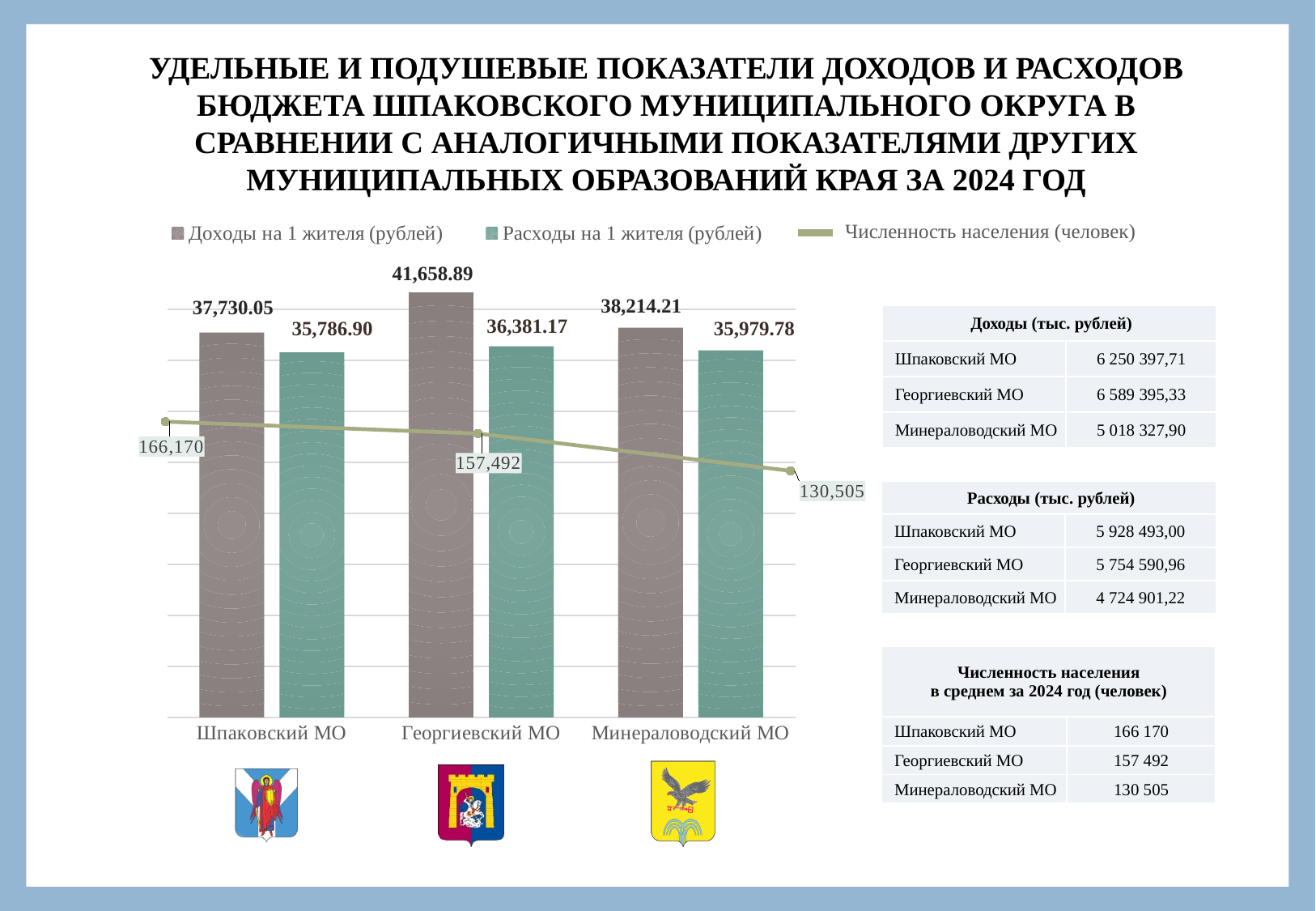
Does the Численность населения line rise or fall from Шпаковский МО to Минераловодский МО? Falls How many municipalities are shown on the x axis of the chart? 3 What is the difference in Численность населения between Шпаковский МО and Минераловодский МО? 35,665 What is the difference between Доходы на 1 жителя and Расходы на 1 жителя for Георгиевский МО? 5,277.72 How many series does the chart legend list? 3 What kind of chart is shown on the slide? Combined bar and line chart Which municipality has the highest Доходы на 1 жителя (рублей)? Георгиевский МО What is the Численность населения (человек) value shown for Минераловодский МО? 130,505 What is the value of Доходы на 1 жителя (рублей) for Георгиевский МО? 41,658.89 Which municipality has the lowest Расходы на 1 жителя (рублей)? Шпаковский МО What is the value of Расходы на 1 жителя (рублей) for Шпаковский МО? 35,786.90 Which is larger: Доходы на 1 жителя for Минераловодский МО or for Шпаковский МО? Минераловодский МО